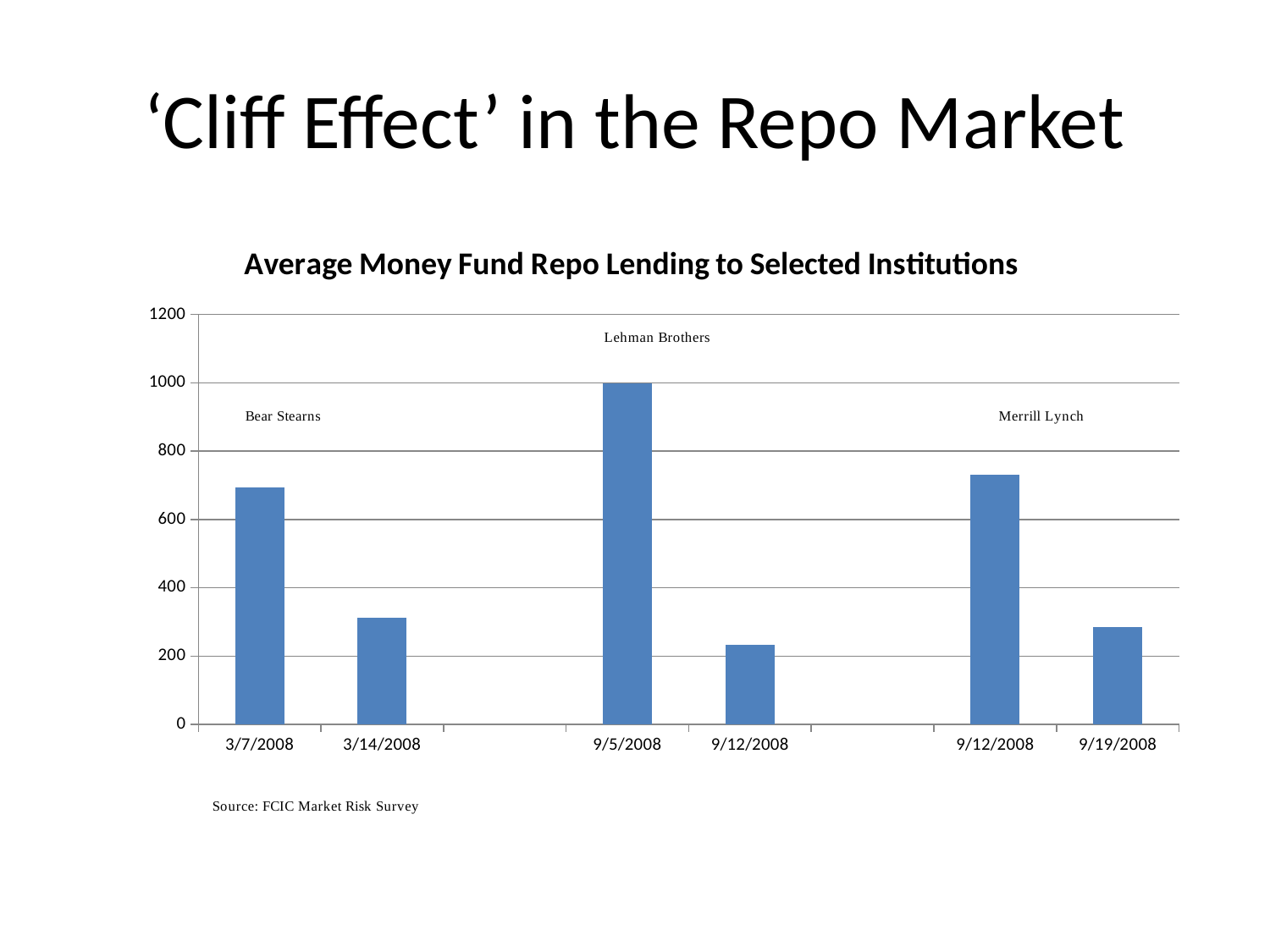
Is the value for 9/5/2008 greater or less than 800? greater Is the value for 9/19/2008 greater or less than 400? less Which is larger, the value for 3/7/2008 or the value for 3/14/2008? 3/7/2008 Which institutions are labelled on the chart? Bear Stearns, Lehman Brothers, Merrill Lynch How many bars are plotted in the chart? 6 What kind of chart is shown on the slide? bar chart Is the value for 3/14/2008 greater or less than 400? less Which bar is the lowest in the chart? 9/12/2008 (Lehman Brothers) Which date has the highest bar in the chart? 9/5/2008 Which is larger, the Merrill Lynch value for 9/12/2008 or the value for 9/19/2008? 9/12/2008 What is the title of the chart? Average Money Fund Repo Lending to Selected Institutions